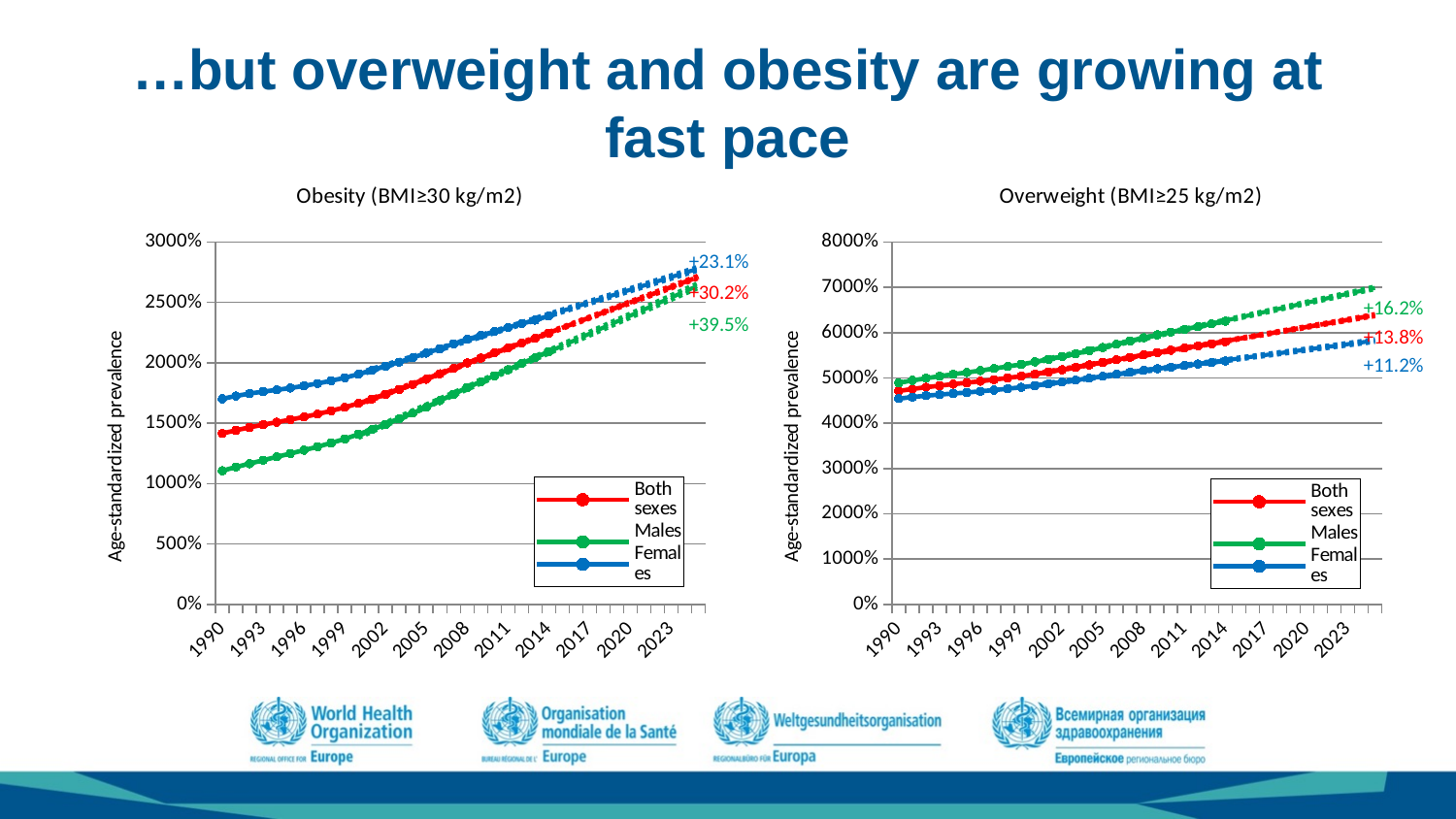
In the Overweight (BMI≥25 kg/m2) chart, what percentage increase is annotated for Females? +11.2% How many series does the legend of the Overweight (BMI≥25 kg/m2) chart list? 3 In the Obesity (BMI≥30 kg/m2) chart, which series has the highest prevalence in 1990? Females In the Obesity (BMI≥30 kg/m2) chart, do the values rise or fall from 1990 to 2023? rise What kind of chart is the Obesity (BMI≥30 kg/m2) chart on the left? line chart In the Overweight (BMI≥25 kg/m2) chart, which series has the lowest prevalence in 1990? Females In the Overweight (BMI≥25 kg/m2) chart, is the value for Females in 1990 greater or less than 5000%? less In the Obesity (BMI≥30 kg/m2) chart, is the value for Females in 1990 greater or less than 1500%? greater In the Obesity (BMI≥30 kg/m2) chart, what percentage increase is annotated for Both sexes? +30.2% In the Overweight (BMI≥25 kg/m2) chart, what percentage increase is annotated for Males? +16.2% What is the y-axis label of the Overweight (BMI≥25 kg/m2) chart? Age-standardized prevalence In the Obesity (BMI≥30 kg/m2) chart, what percentage increase is annotated for Males? +39.5%